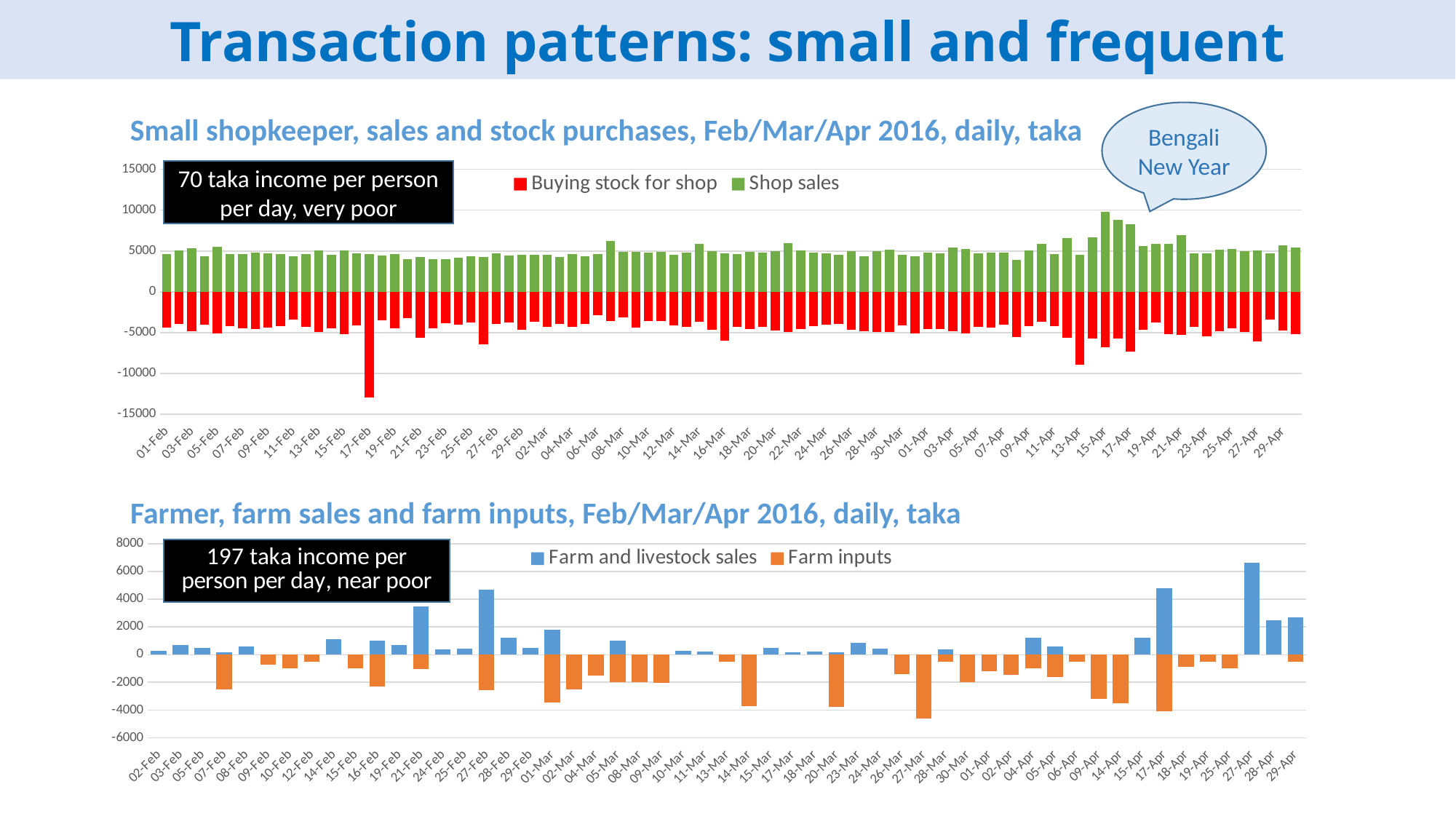
In the 'Farmer, farm sales and farm inputs' chart, what colour represents 'Farm inputs'? Orange In the 'Small shopkeeper' chart, is the 'Buying stock for shop' value on 17-Feb greater or less than -10000? less In the 'Farmer, farm sales and farm inputs' chart, on which date is the 'Farm and livestock sales' bar the highest? 27-Apr In the 'Farmer, farm sales and farm inputs' chart, is the 'Farm inputs' value on 27-Mar greater or less than -4000? less In the 'Small shopkeeper' chart, which is larger: 'Shop sales' on 15-Apr or 'Shop sales' on 01-Feb? 15-Apr How many series does the legend of the 'Farmer, farm sales and farm inputs' chart list? 2 In the 'Small shopkeeper' chart, on which date is the 'Buying stock for shop' bar the lowest (most negative)? 17-Feb What kind of chart is the 'Small shopkeeper, sales and stock purchases' chart? Bar chart In the 'Farmer, farm sales and farm inputs' chart, is the 'Farm and livestock sales' value on 27-Apr greater or less than 6000? greater How many series does the legend of the 'Small shopkeeper, sales and stock purchases' chart list? 2 In the 'Farmer, farm sales and farm inputs' chart, which is larger: 'Farm and livestock sales' on 27-Apr or on 27-Feb? 27-Apr